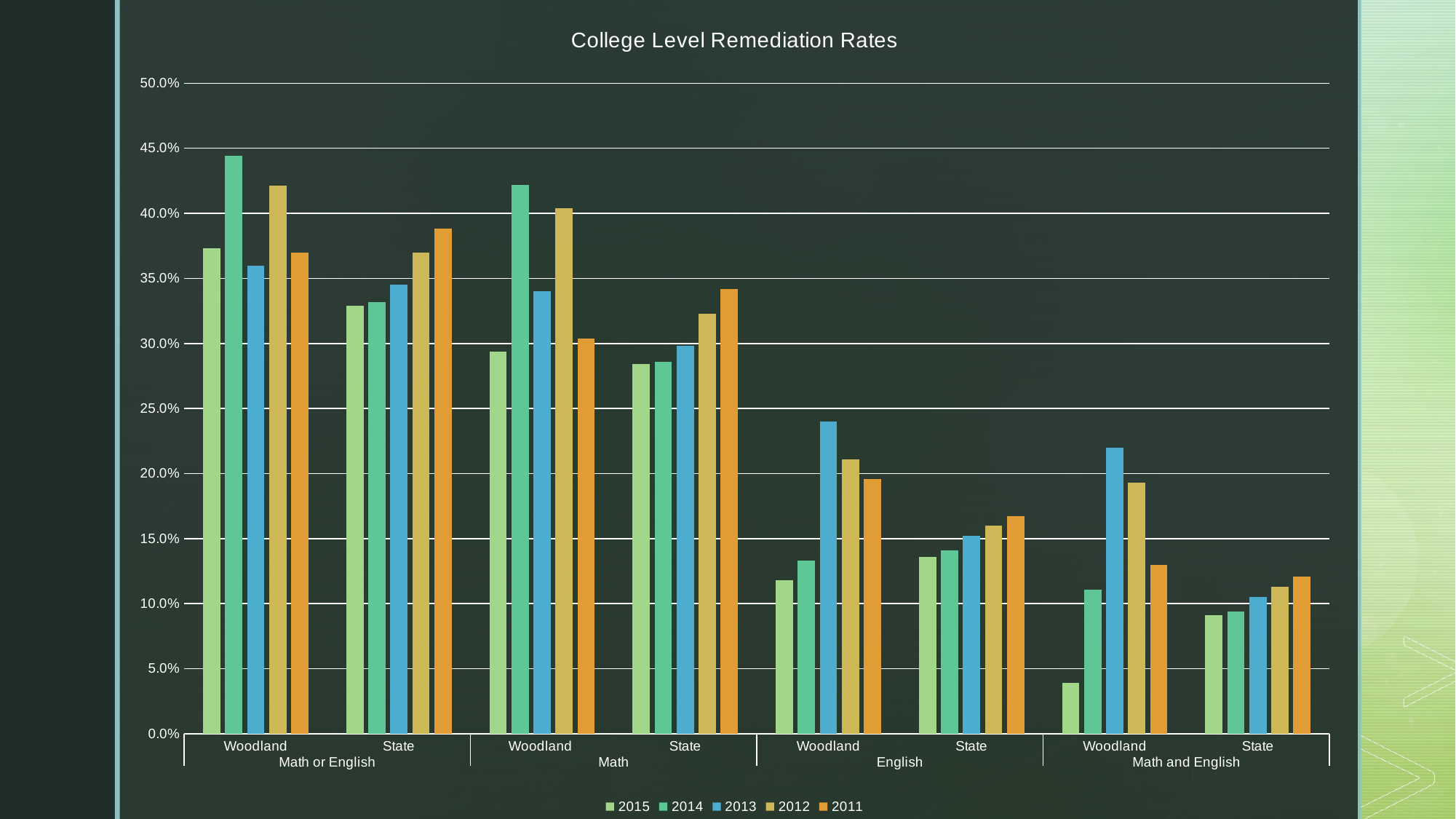
For Woodland in the English group, which year has the highest remediation rate? 2013 In the English group, which has the larger 2013 value, Woodland or State? Woodland What is the title of the chart? College Level Remediation Rates Is the 2014 value for Woodland in the Math group greater or less than 40.0%? greater How many series does the legend list? 5 Is the 2015 value for Woodland in the Math and English group greater or less than 5.0%? less What kind of chart is shown on the slide? bar chart In the Math or English group, which has the larger 2011 value, Woodland or State? State Is the 2013 value for Woodland in the English group greater or less than 20.0%? greater Which bar is the lowest on the whole chart? 2015 Woodland, Math and English How many subject groups are shown along the x axis? 4 For Woodland in the Math or English group, which year has the highest remediation rate? 2014